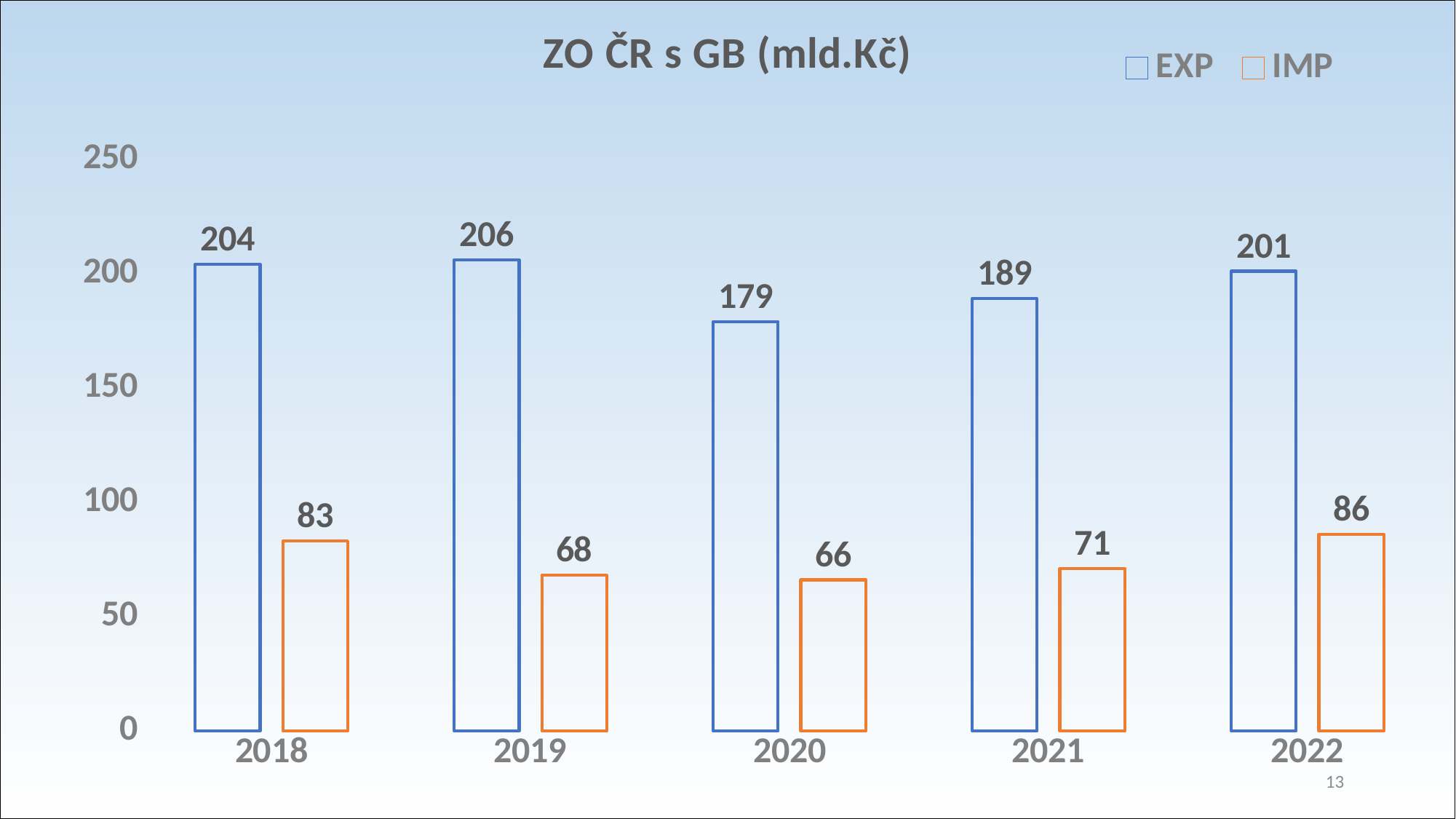
What is the title of the chart? ZO ČR s GB (mld.Kč) Which is larger, the EXP value for 2021 or the EXP value for 2022? 2022 How many series does the legend list? 2 Which year has the highest EXP value? 2019 What is the IMP value for 2020? 66 Which year has the lowest IMP value? 2020 Does the IMP value rise or fall from 2021 to 2022? rise What is the IMP value for 2022? 86 What is the EXP value for 2019? 206 What kind of chart is shown on the slide? bar chart How many years are shown on the x axis? 5 What is the difference between the EXP and IMP values in 2018? 121